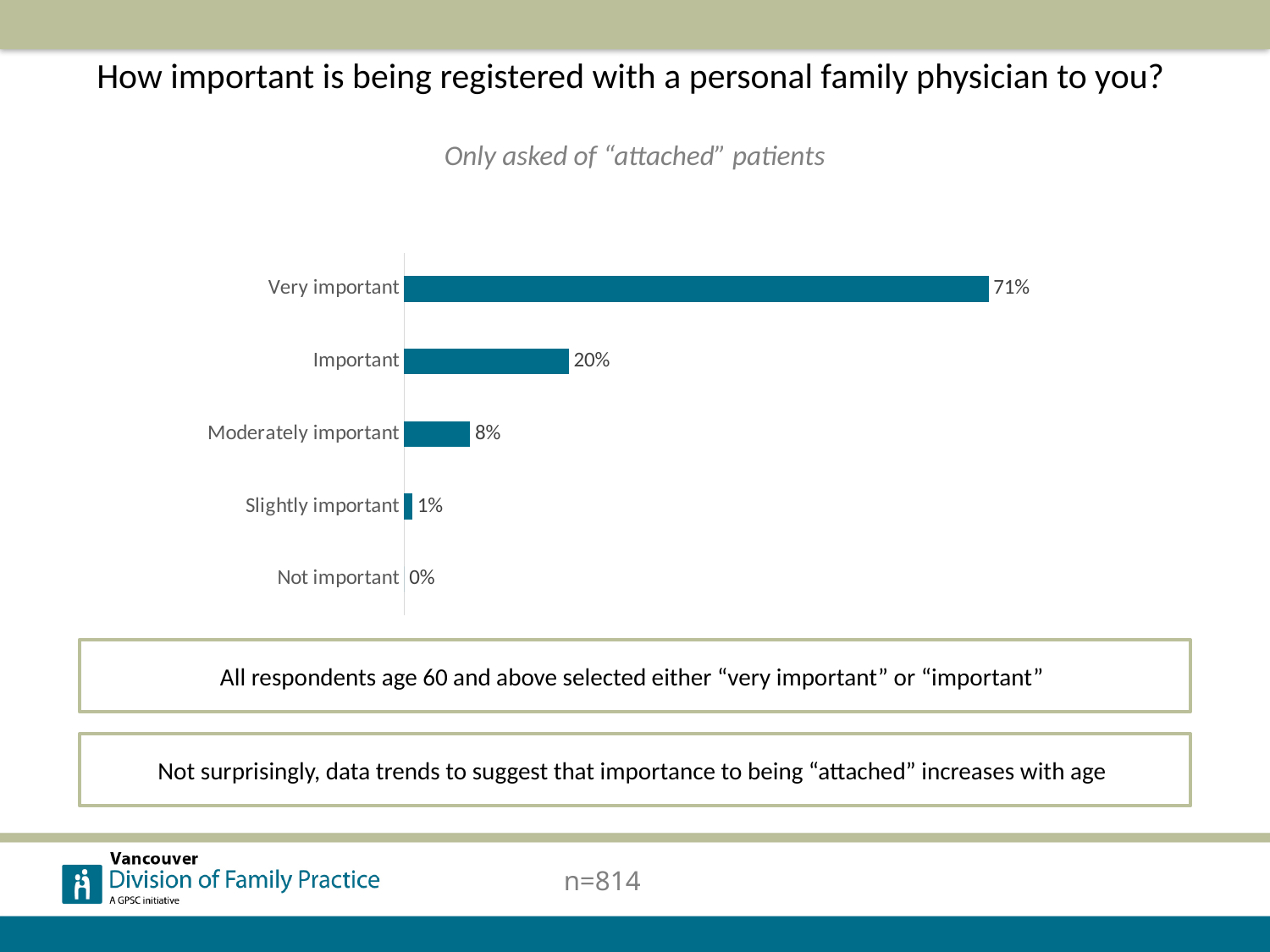
What kind of chart is shown on the slide? Bar chart Which has a larger percentage, "Important" or "Moderately important"? Important What percentage of respondents selected "Very important"? 71% What is the sample size (n) shown on the slide? n=814 Which response category has the highest percentage? Very important What percentage of respondents selected "Moderately important"? 8% How many response categories are shown in the chart? 5 What percentage of respondents selected "Important"? 20% What percentage of respondents selected "Not important"? 0% What percentage of respondents selected "Slightly important"? 1% Which response category has the lowest percentage? Not important What is the difference in percentage points between "Very important" and "Important"? 51